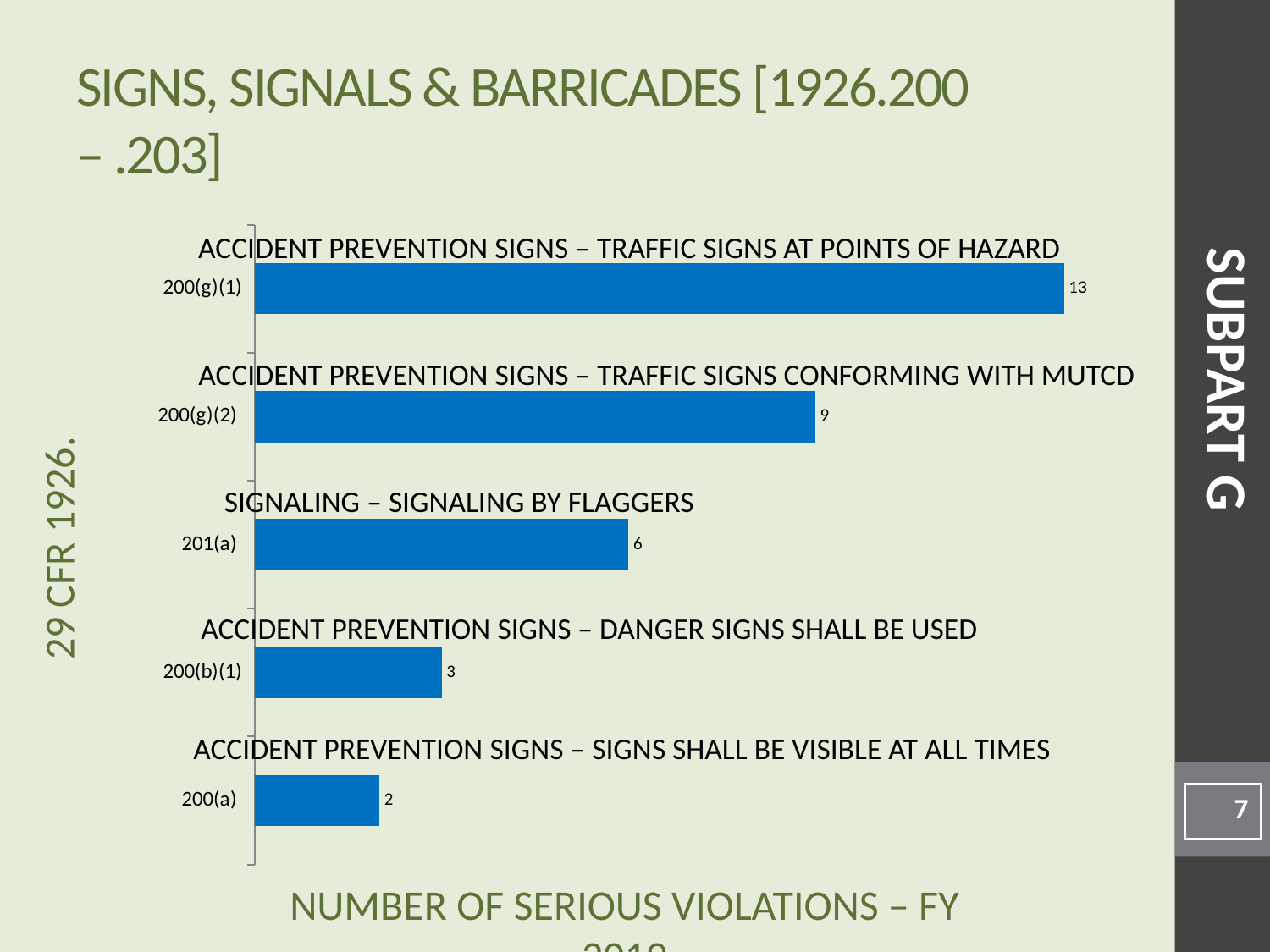
What is the number of serious violations for 201(a)? 6 Which category has the highest number of serious violations? 200(g)(1) What is the number of serious violations for 200(b)(1)? 3 How many categories are shown in the chart? 5 What is the difference between the values for 200(g)(1) and 200(g)(2)? 4 What is the number of serious violations for 200(g)(2)? 9 Which category has the lowest number of serious violations? 200(a) What is the number of serious violations for 200(a)? 2 What kind of chart is shown on the slide? Bar chart What is the number of serious violations for 200(g)(1)? 13 Which has more serious violations, 201(a) or 200(b)(1)? 201(a)